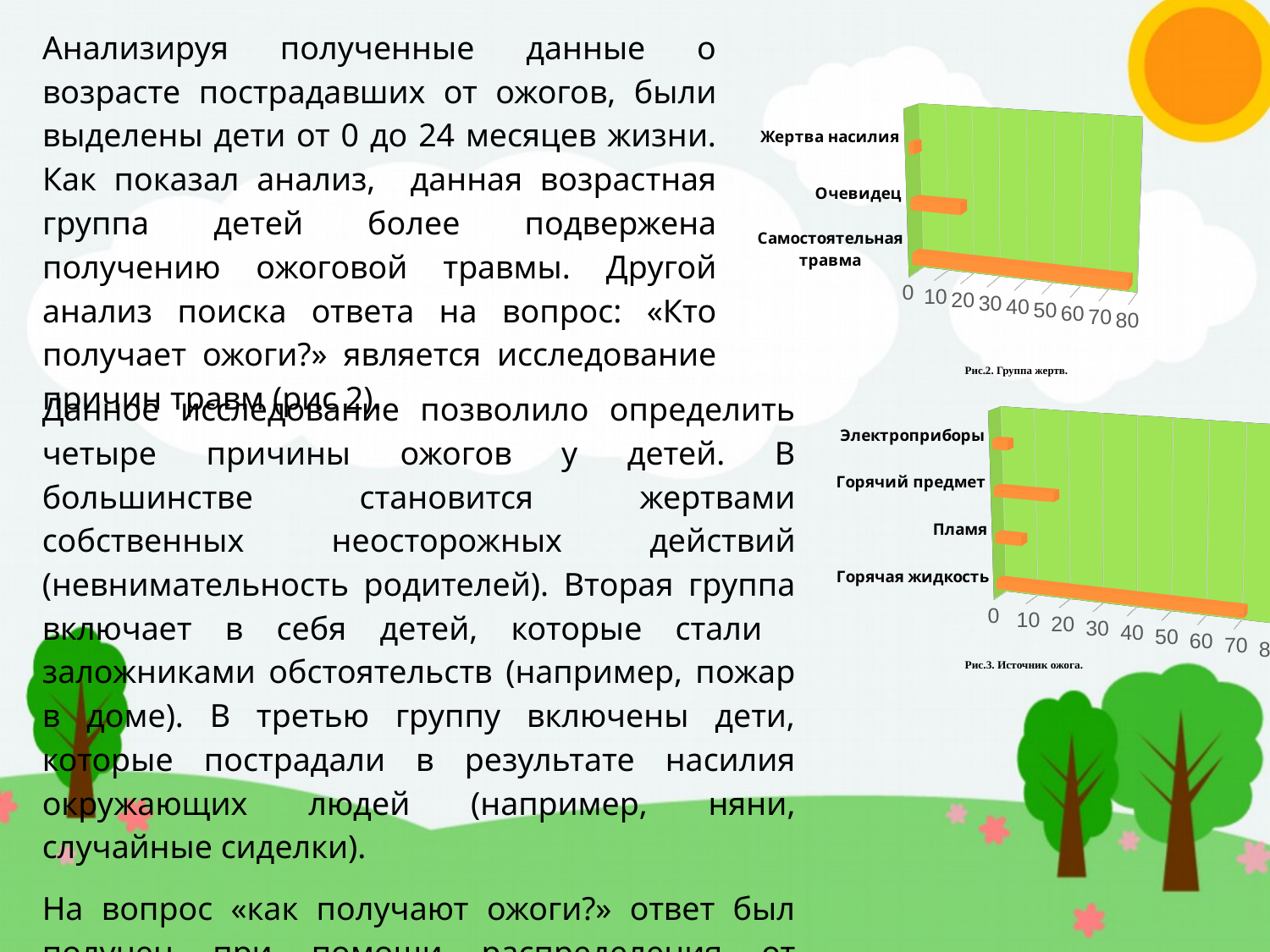
On the chart titled 'Рис.2. Группа жертв.', is the value for Самостоятельная травма greater or less than 60? greater On the chart titled 'Рис.3. Источник ожога.', how many categories are plotted? 4 What kind of chart is 'Рис.3. Источник ожога.'? bar chart On the chart titled 'Рис.2. Группа жертв.', is the value for Очевидец greater or less than 30? less On the chart titled 'Рис.3. Источник ожога.', is the value for Горячий предмет greater or less than 30? less On the chart titled 'Рис.3. Источник ожога.', which is larger, the value for Горячий предмет or the value for Пламя? Горячий предмет On the chart titled 'Рис.2. Группа жертв.', which category has the highest value? Самостоятельная травма On the chart titled 'Рис.3. Источник ожога.', which category has the highest value? Горячая жидкость On the chart titled 'Рис.2. Группа жертв.', how many categories are plotted? 3 On the chart titled 'Рис.2. Группа жертв.', which category has the lowest value? Жертва насилия On the chart titled 'Рис.2. Группа жертв.', which is larger, the value for Очевидец or the value for Жертва насилия? Очевидец